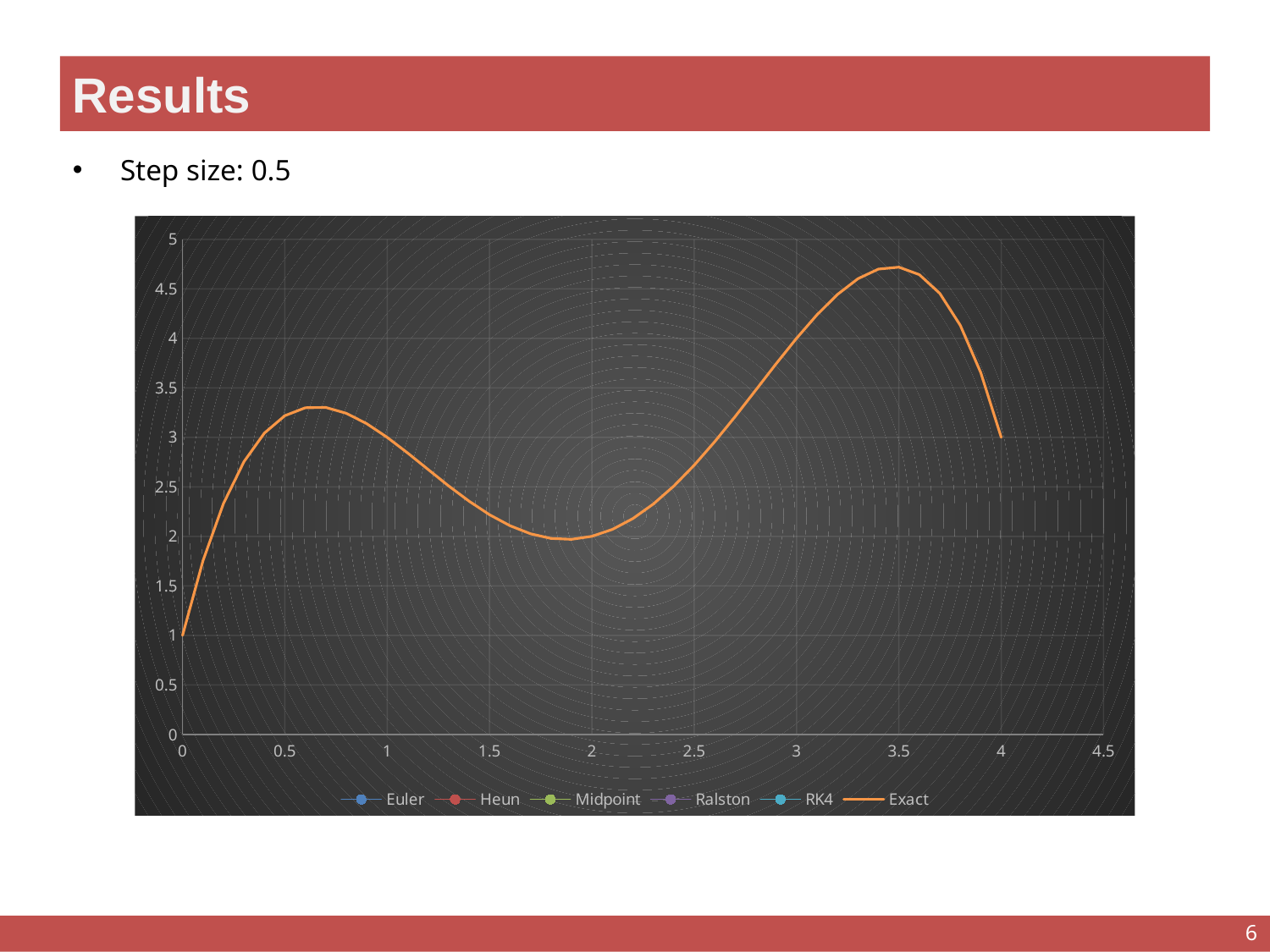
Is the value of the Exact curve at x = 4 greater or less than 3.5? less Which is larger for the Exact curve: the value at x = 0.5 or the value at x = 2? x = 0.5 Does the Exact curve rise or fall between x = 0 and x = 0.5? rise Does the Exact curve rise or fall between x = 3.5 and x = 4? fall Which series in the legend is drawn in orange? Exact Is the value of the Exact curve at x = 1.5 greater or less than 2.5? less Is the value of the Exact curve at x = 2 greater or less than 2.5? less Which series is the only one visibly plotted on the chart? Exact What kind of chart is shown on the slide? line chart How many series does the chart's legend list? 6